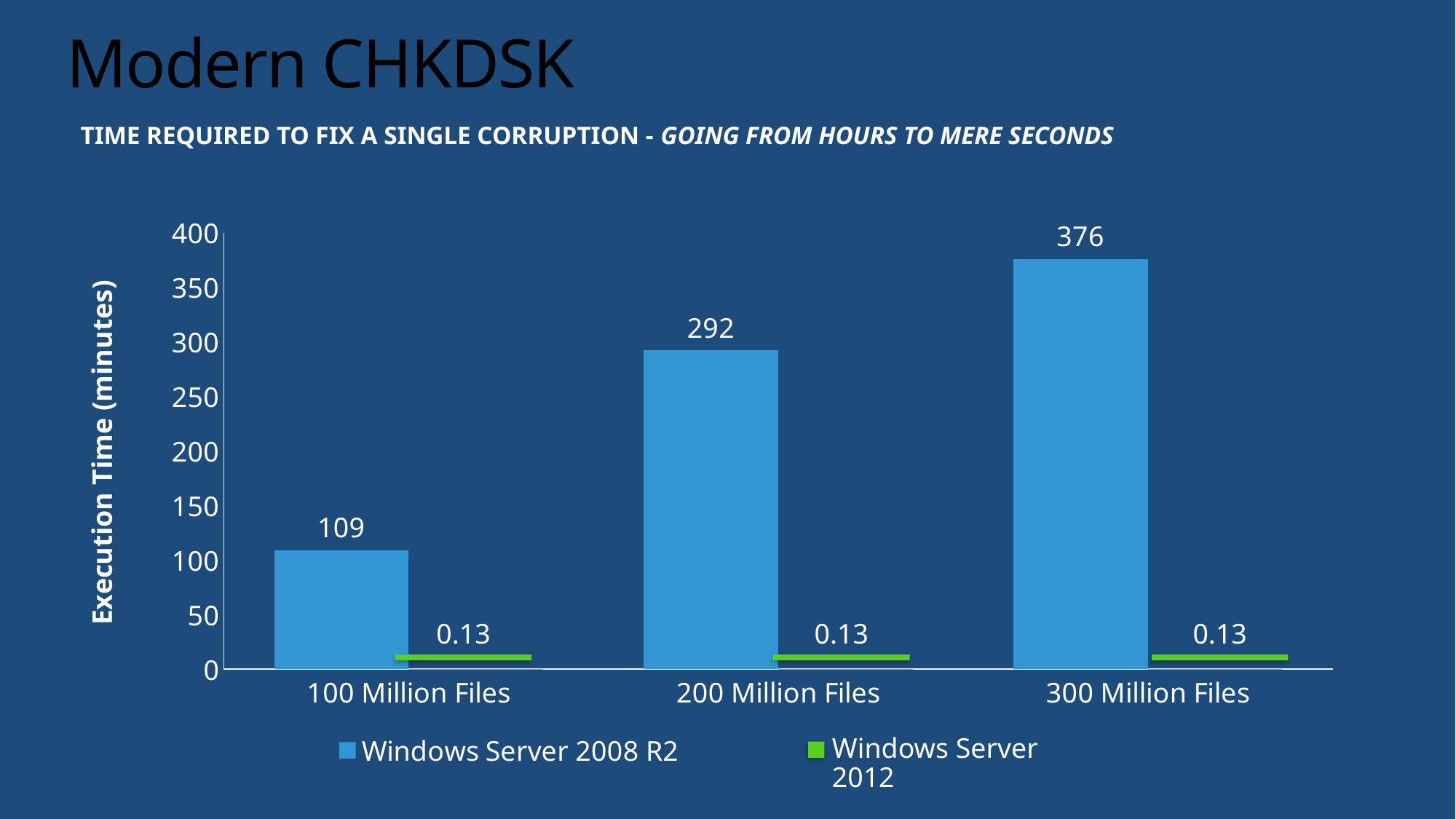
How many file-count categories are shown on the x axis? 3 What kind of chart is shown on the slide? Bar chart Which file count has the lowest execution time for Windows Server 2008 R2? 100 Million Files What is the label of the vertical axis? Execution Time (minutes) What is the execution time for Windows Server 2008 R2 at 100 Million Files? 109 Is the Windows Server 2008 R2 execution time at 200 Million Files greater or less than 250? greater What is the difference in execution time between Windows Server 2008 R2 at 300 Million Files and at 100 Million Files? 267 How many series does the legend list? 2 What is the execution time for Windows Server 2008 R2 at 200 Million Files? 292 Which is larger: the Windows Server 2008 R2 execution time at 200 Million Files or at 300 Million Files? 300 Million Files What is the execution time for Windows Server 2012 at 300 Million Files? 0.13 Which file count has the highest execution time for Windows Server 2008 R2? 300 Million Files